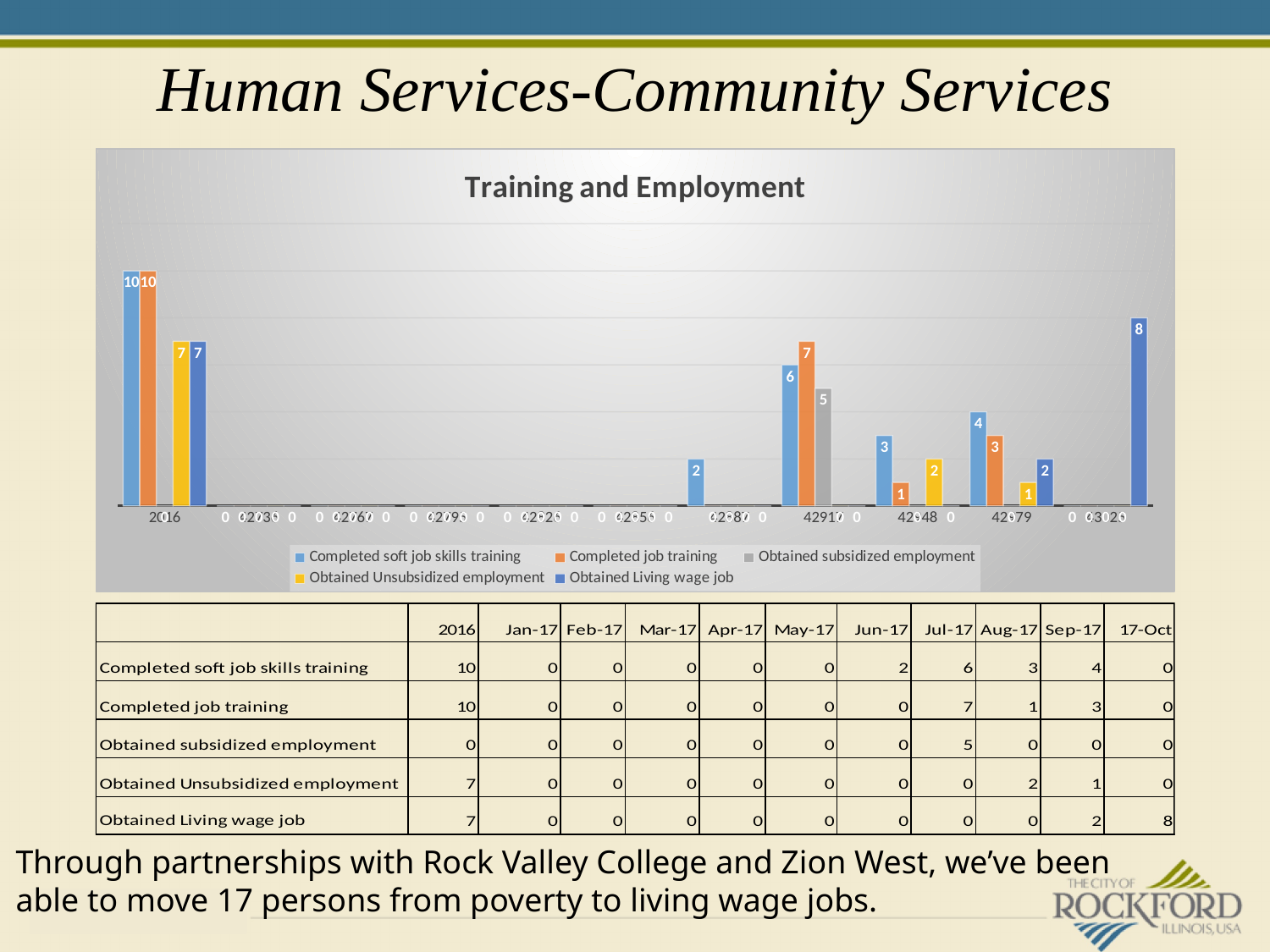
What kind of chart is the Training and Employment chart? bar chart How many series does the legend of the Training and Employment chart list? 5 In the Training and Employment chart, what is the highest value shown for Obtained Living wage job? 8 In the Training and Employment chart, what is the highest value shown for Completed job training? 10 How many categories are shown along the x axis of the Training and Employment chart? 11 In the Training and Employment chart, which is larger in 2016: Completed job training or Obtained Living wage job? Completed job training In the Training and Employment chart, what is the value for Completed soft job skills training in 2016? 10 In the Training and Employment chart, what is the difference between Completed soft job skills training and Obtained Unsubsidized employment in 2016? 3 In the Training and Employment chart, what is the highest value shown for Obtained subsidized employment? 5 In the Training and Employment chart, what colour represents Obtained subsidized employment? gray In the Training and Employment chart, what is the value for Obtained Living wage job in 2016? 7 What is the title of the chart on the slide? Training and Employment